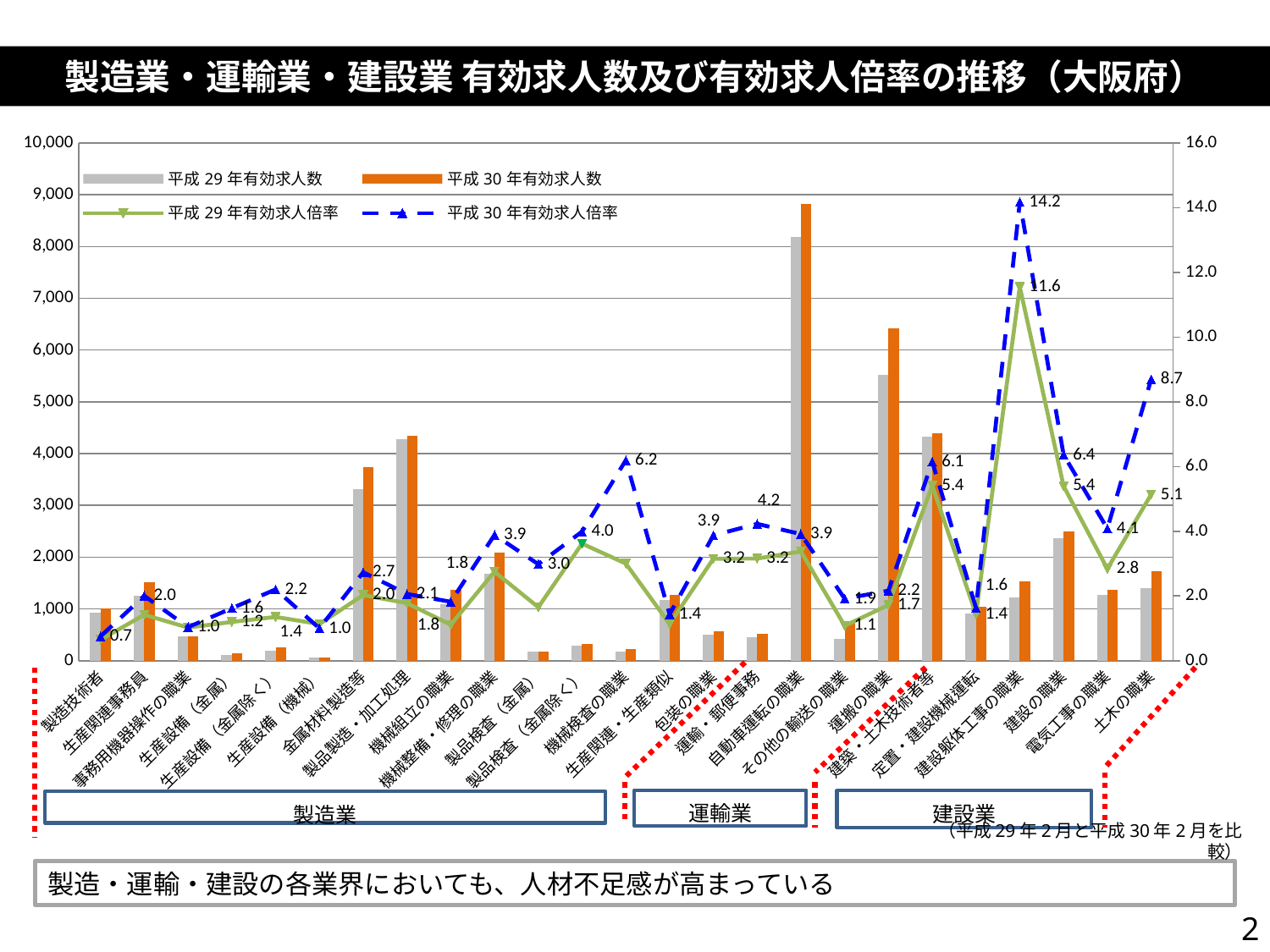
How many occupation categories are plotted along the x axis? 25 What is the title of the chart? 製造業・運輸業・建設業 有効求人数及び有効求人倍率の推移（大阪府） What is the 平成29年有効求人倍率 for 建設躯体工事の職業? 11.6 What is the 平成30年有効求人倍率 for 土木の職業? 8.7 What is the 平成30年有効求人倍率 for 建設躯体工事の職業? 14.2 How many series does the legend list? 4 What is the 平成30年有効求人倍率 for 建設の職業? 6.4 What is the difference between the 平成30年 and 平成29年 有効求人倍率 for 建設躯体工事の職業? 2.6 Which occupation has the highest 平成30年有効求人倍率? 建設躯体工事の職業 Which has the larger 平成30年有効求人数: 自動車運転の職業 or 運搬の職業? 自動車運転の職業 What kind of chart is shown on the slide? A combination bar and line chart Is the 平成30年有効求人数 for 自動車運転の職業 greater or less than 8,000? greater